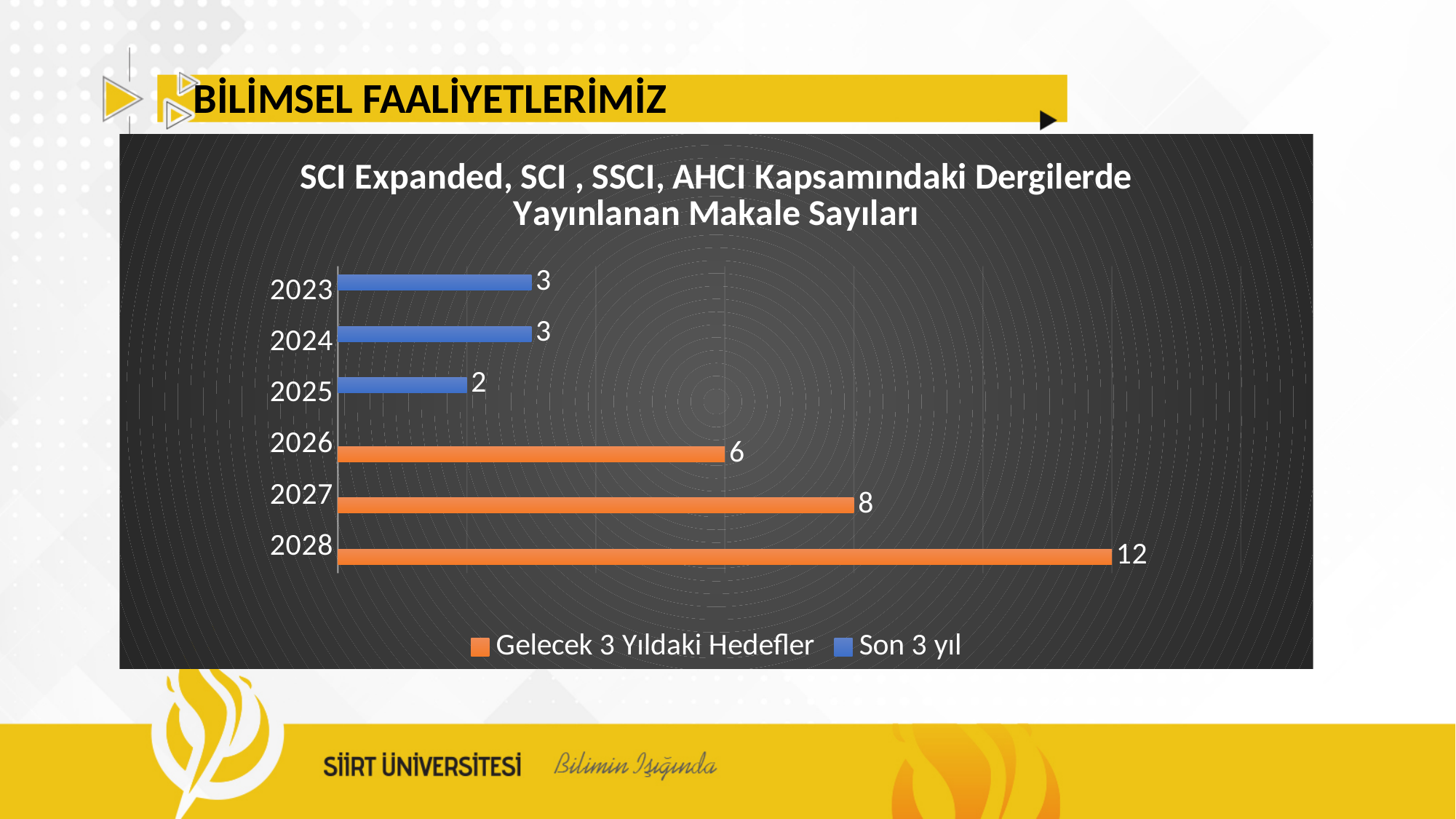
Which is larger, the value for 2027 or the value for 2024? 2027 What is the value for 2025 in the chart? 2 How many years are shown in the chart? 6 What kind of chart is shown on the slide? Bar chart What is the value for 2027 in the chart? 8 Which year has the highest value in the chart? 2028 Which year has the lowest value in the chart? 2025 What is the value for 2023 in the chart? 3 What is the value for 2028 in the chart? 12 What is the difference between the values for 2028 and 2026? 6 How many series does the legend list? 2 Which series is shown in orange in the chart? Gelecek 3 Yıldaki Hedefler